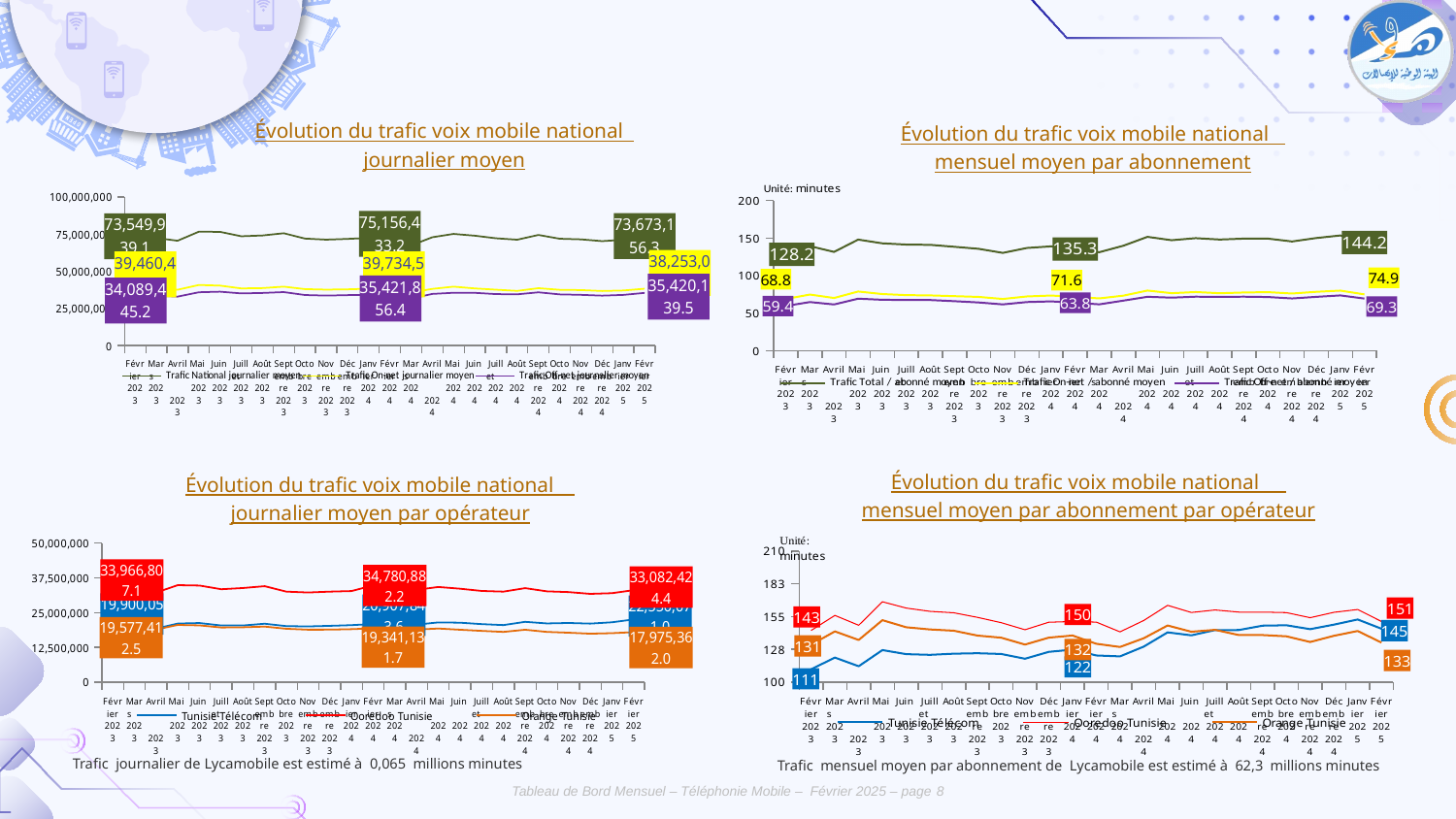
In the chart 'Évolution du trafic voix mobile national mensuel moyen par abonnement', what is the value of Trafic On-net / abonné moyen for Févr 2023? 68.8 In the chart 'Évolution du trafic voix mobile national journalier moyen', is the value of Trafic National journalier moyen for Févr 2024 greater or less than 50,000,000? greater In the chart 'Évolution du trafic voix mobile national mensuel moyen par abonnement par opérateur', which operator has the highest value in Févr 2023? Ooredoo Tunisie In the chart 'Évolution du trafic voix mobile national mensuel moyen par abonnement par opérateur', does the value for Tunisie Télécom rise or fall from Févr 2023 to Févr 2025? rise What kind of chart is 'Évolution du trafic voix mobile national journalier moyen'? line chart How many series does the legend list in the chart 'Évolution du trafic voix mobile national mensuel moyen par abonnement'? 3 In the chart 'Évolution du trafic voix mobile national mensuel moyen par abonnement par opérateur', what is the value for Ooredoo Tunisie in Févr 2024? 150 In the chart 'Évolution du trafic voix mobile national mensuel moyen par abonnement', what is the value of Trafic Total / abonné moyen for Févr 2025? 144.2 In the chart 'Évolution du trafic voix mobile national mensuel moyen par abonnement', what is the difference between Trafic Total / abonné moyen and Trafic Off-net / abonné moyen in Févr 2024? 71.5 In the chart 'Évolution du trafic voix mobile national mensuel moyen par abonnement par opérateur', what is the difference between Ooredoo Tunisie and Orange Tunisie in Févr 2025? 18 In the chart 'Évolution du trafic voix mobile national mensuel moyen par abonnement par opérateur', what is the value for Tunisie Télécom in Févr 2025? 145 In the chart 'Évolution du trafic voix mobile national journalier moyen par opérateur', which operator has the highest value in Févr 2025? Ooredoo Tunisie